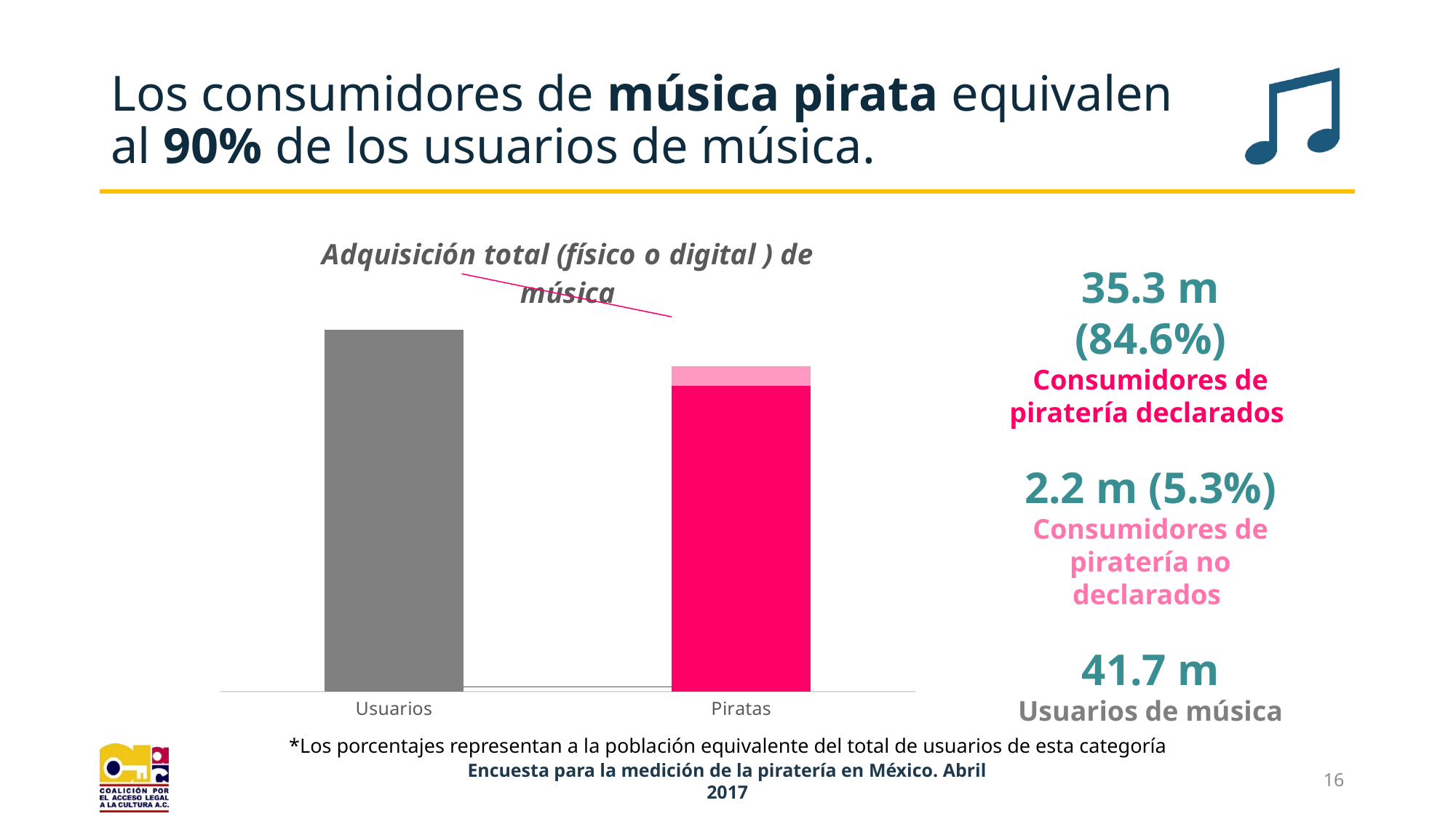
What percentage of music users do the Consumidores de piratería no declarados represent? 5.3% What kind of chart is shown on the slide? Bar chart How many Consumidores de piratería no declarados does the slide report? 2.2 m Which category has the taller bar, Usuarios or Piratas? Usuarios What is the difference between the declared (35.3 m) and undeclared (2.2 m) pirate consumers? 33.1 m What percentage of music users do the Consumidores de piratería declarados represent? 84.6% How many Consumidores de piratería declarados does the slide report? 35.3 m How many categories are shown on the x axis of the chart? 2 Which segment of the Piratas bar is larger, the dark pink (declarados) or the light pink (no declarados)? Dark pink (declarados) According to the slide, how many Usuarios de música are there? 41.7 m What is the total of the stacked Piratas bar (declared plus undeclared pirate consumers)? 37.5 m Is the bar for Piratas taller or shorter than the bar for Usuarios? Shorter